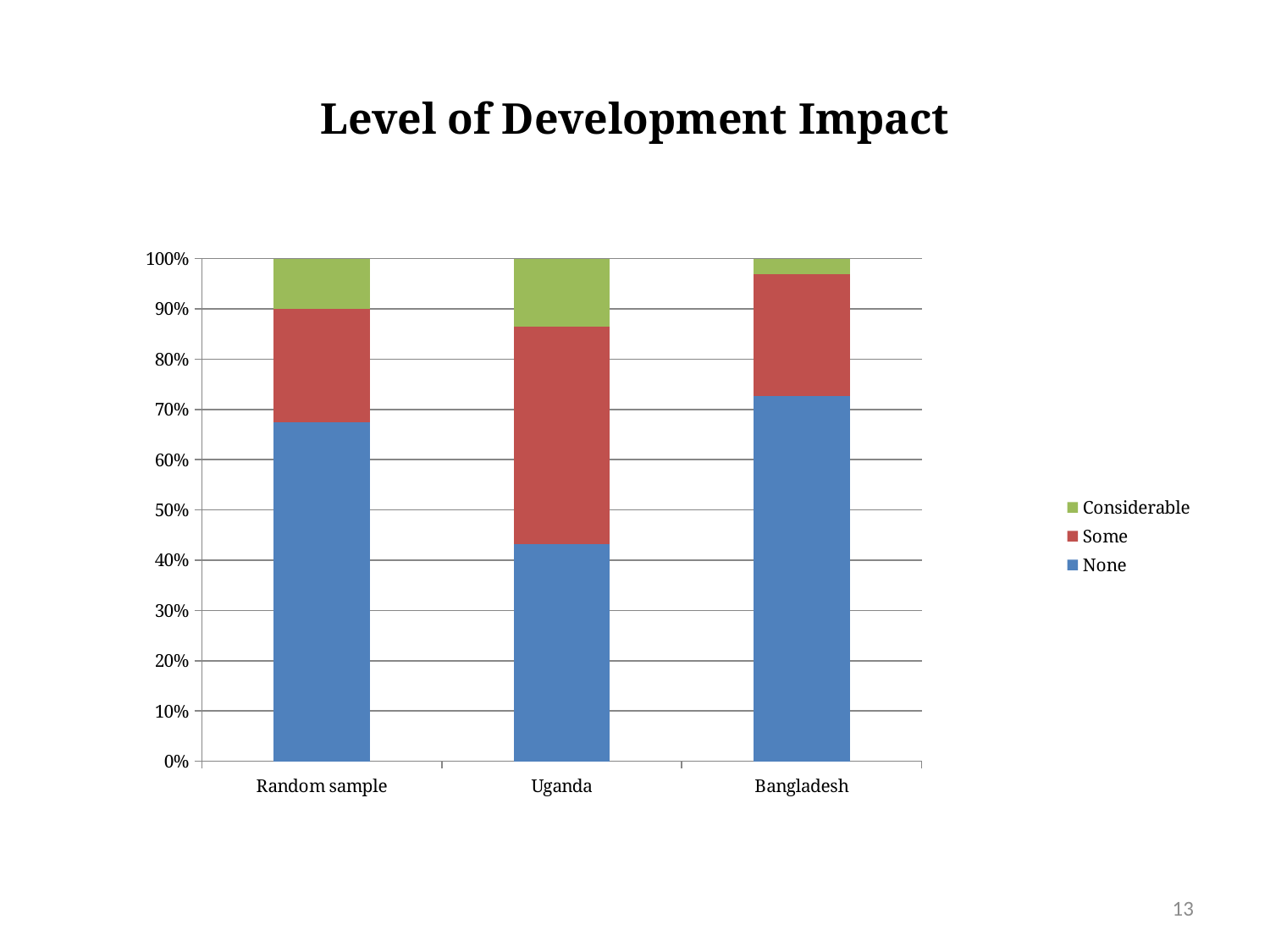
How many series does the legend list? 3 Is the 'None' share for Random sample greater or less than 60%? greater Which has a larger 'None' share, Random sample or Uganda? Random sample Which colour represents the 'None' series? Blue How many categories are shown on the x axis? 3 Is the 'None' share for Uganda greater or less than 50%? less Which category has the smallest 'Considerable' segment? Bangladesh What kind of chart is shown on the slide? Stacked bar chart What is the title of the chart? Level of Development Impact Which category has the smallest 'None' segment? Uganda Which category has the largest 'Some' segment? Uganda Which category has the largest 'None' segment? Bangladesh